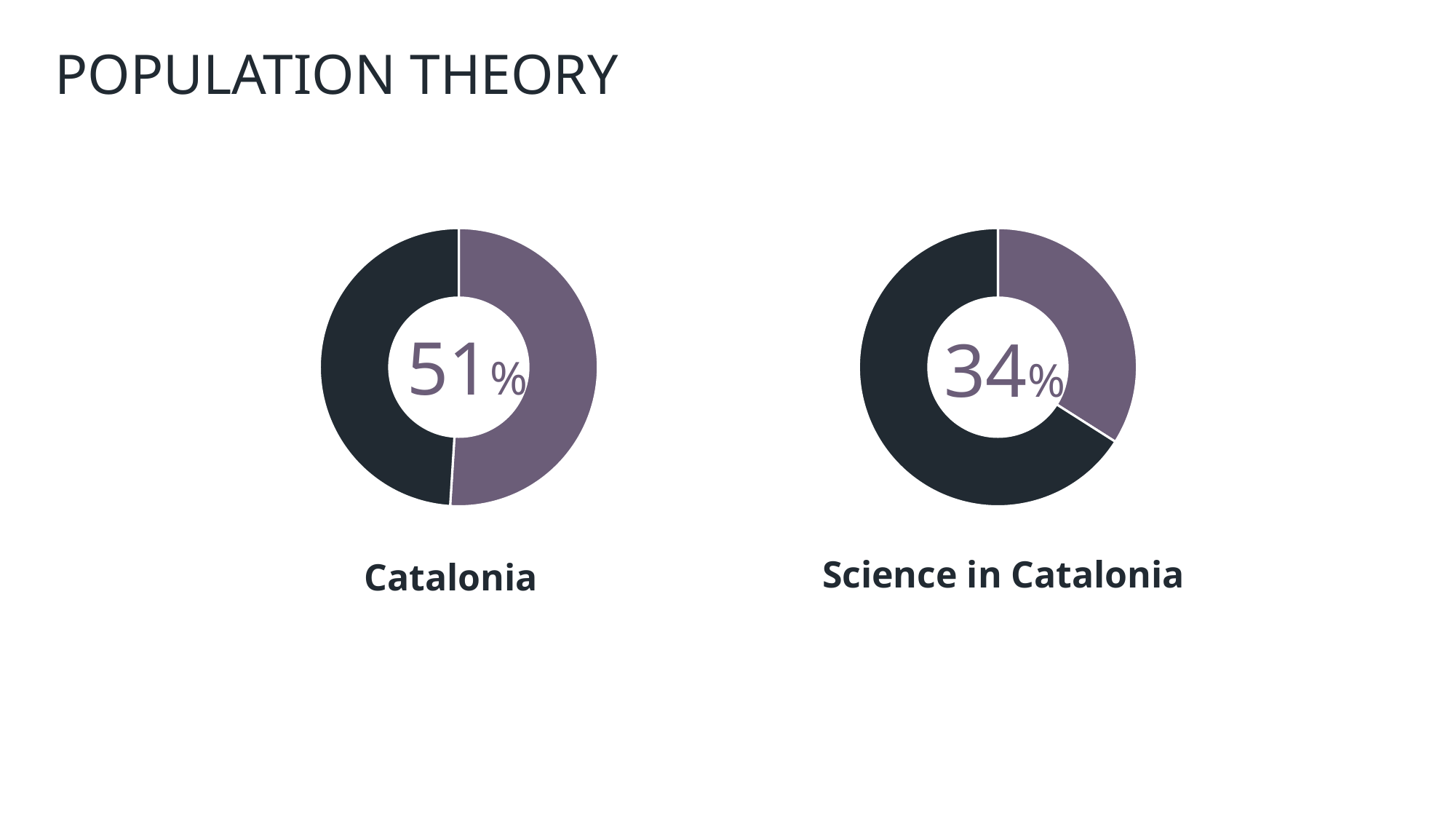
How many donut charts are shown on the slide? 2 In the Catalonia chart, what share of the donut does the purple slice represent? 51% In the Science in Catalonia chart, what percentage is shown in the centre of the donut? 34% Which chart shows the higher percentage, Catalonia or Science in Catalonia? Catalonia What is the difference between the percentage shown for Catalonia and the percentage shown for Science in Catalonia? 17% What kind of chart is used for Catalonia? Donut (pie) chart What is the title of the slide containing the two donut charts? POPULATION THEORY In the Science in Catalonia chart, is the purple slice larger or smaller than the dark slice? Smaller In the Catalonia chart, what percentage is shown in the centre of the donut? 51% How many slices does the Science in Catalonia donut chart have? 2 In the Science in Catalonia chart, what share of the donut does the purple slice represent? 34% What colour is the slice that represents the labelled percentage in each donut chart? Purple